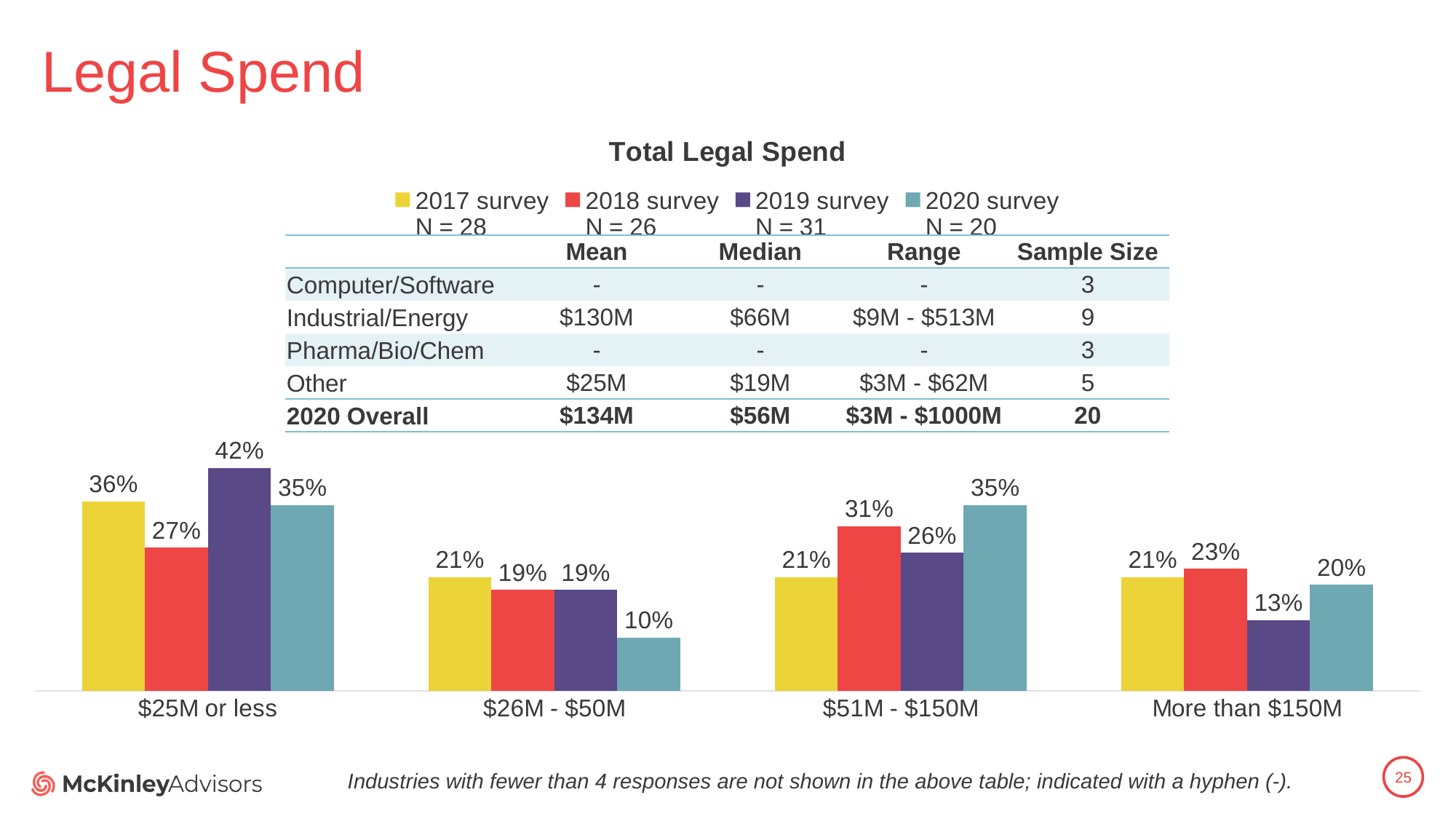
How many series does the chart legend list? 4 Which is larger in the $51M - $150M category: the 2020 survey value or the 2017 survey value? 2020 survey What is the sample size (N) for the 2020 survey shown in the legend? N = 20 What is the value for the 2018 survey in the $51M - $150M category? 31% What kind of chart is shown on the slide? Bar chart What is the value for the 2019 survey in the $25M or less category? 42% Which survey year has the lowest value in the $26M - $50M category? 2020 survey How many spend categories are shown on the x axis of the chart? 4 What is the value for the 2019 survey in the More than $150M category? 13% What is the value for the 2020 survey in the $26M - $50M category? 10% Which survey year has the highest value in the $25M or less category? 2019 survey What is the difference between the 2019 survey and 2018 survey values in the $25M or less category? 15%